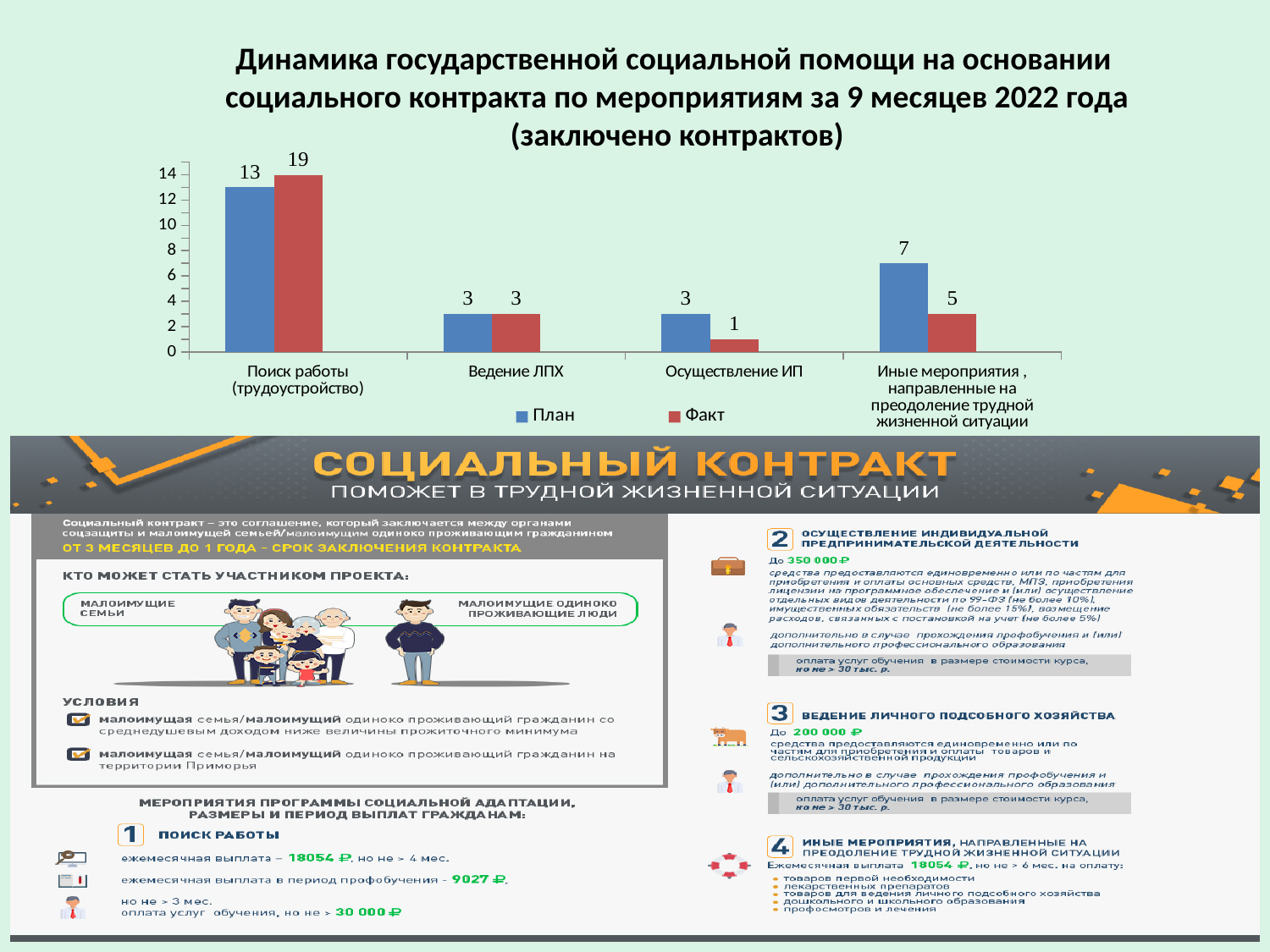
Which category has the highest Факт value? Поиск работы (трудоустройство) What kind of chart is shown on the slide? Bar chart What is the Факт value for Поиск работы (трудоустройство)? 19 How many series does the legend list? 2 What is the План value for Поиск работы (трудоустройство)? 13 What is the Факт value for Осуществление ИП? 1 What colour are the Факт bars? Red For Осуществление ИП, which is larger, План or Факт? План Which category has the lowest Факт value? Осуществление ИП How many categories are shown on the x axis? 4 What is the difference between the План and Факт values for Иные мероприятия, направленные на преодоление трудной жизненной ситуации? 2 What is the План value for Иные мероприятия, направленные на преодоление трудной жизненной ситуации? 7